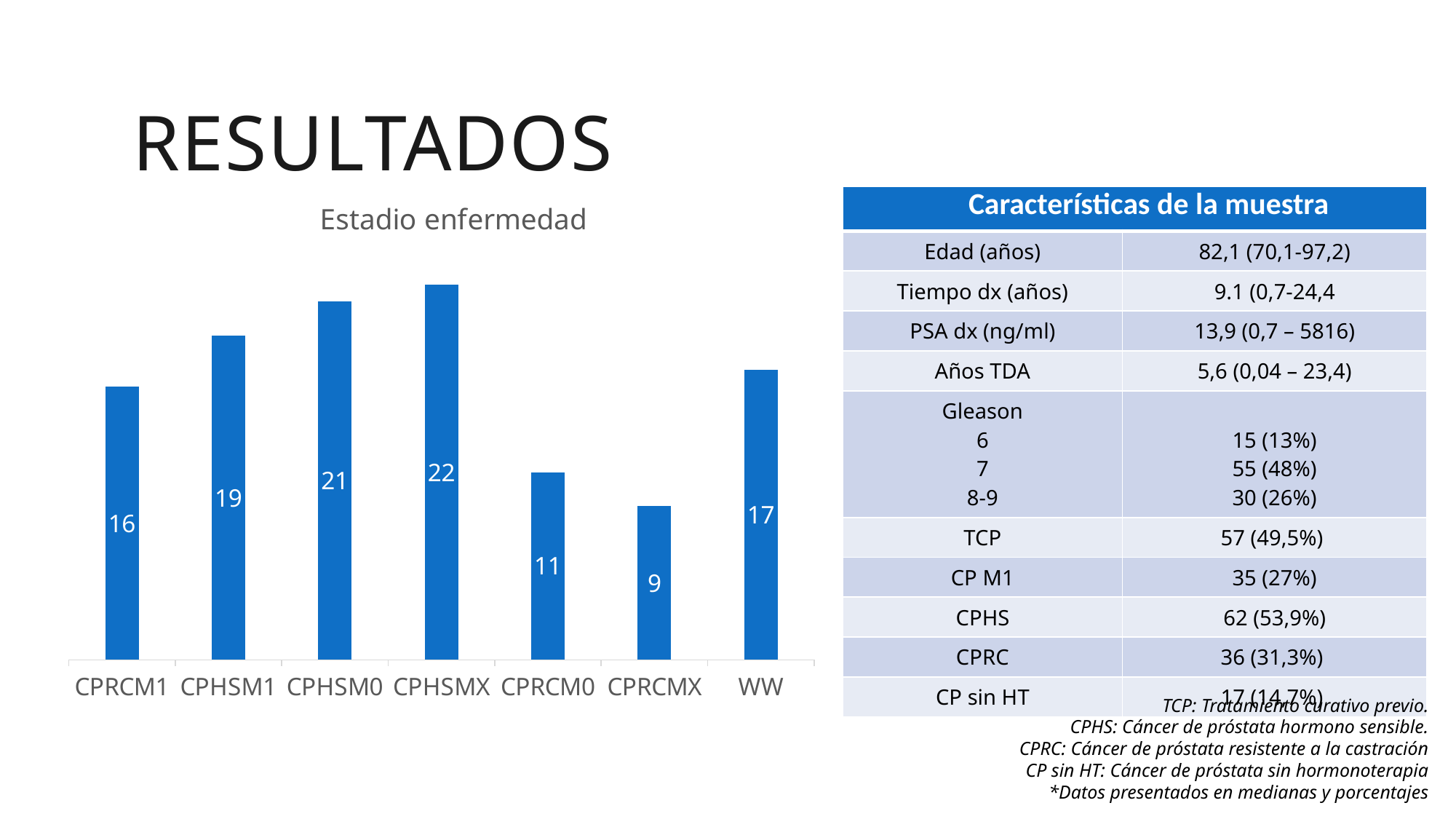
What is the value for WW in the Estadio enfermedad chart? 17 Which category has the highest value in the Estadio enfermedad chart? CPHSMX What is the value for CPRCM1 in the Estadio enfermedad chart? 16 Which is larger in the Estadio enfermedad chart, CPHSM1 or WW? CPHSM1 What is the value for CPRCM0 in the Estadio enfermedad chart? 11 What is the difference between the values for CPHSMX and CPRCMX in the Estadio enfermedad chart? 13 What is the title of the chart on the slide? Estadio enfermedad What is the difference between the values for CPHSM0 and CPRCM0 in the Estadio enfermedad chart? 10 How many categories are shown in the Estadio enfermedad chart? 7 What is the value for CPHSMX in the Estadio enfermedad chart? 22 Which category has the lowest value in the Estadio enfermedad chart? CPRCMX What kind of chart is the Estadio enfermedad chart? bar chart